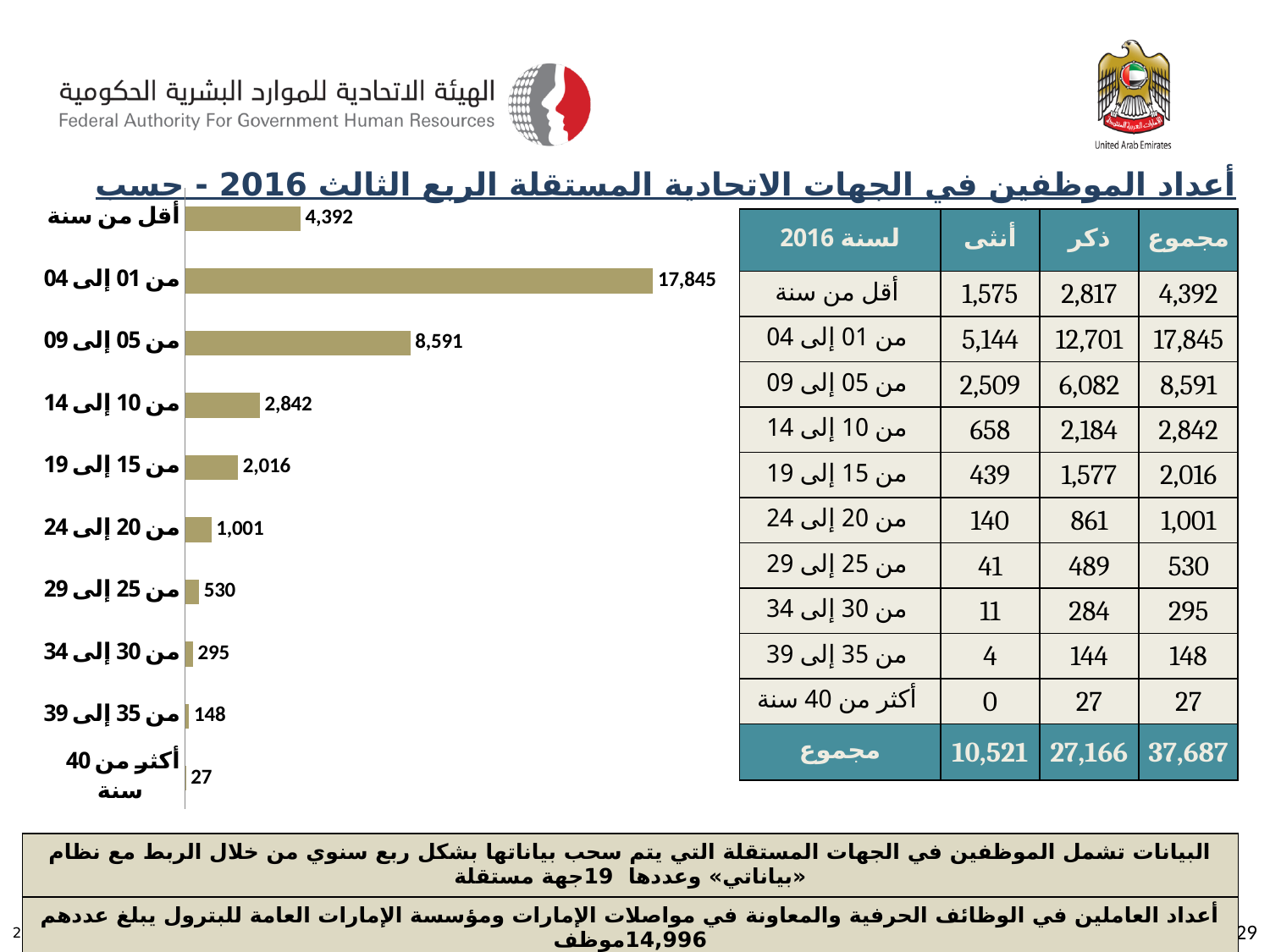
Which category has the highest value in the bar chart? من 01 إلى 04 What is the value for the category "أكثر من 40 سنة" in the bar chart? 27 What is the difference between the values for "من 01 إلى 04" and "من 05 إلى 09" in the bar chart? 9,254 What is the value for the category "من 01 إلى 04" in the bar chart? 17,845 What kind of chart is shown on the slide? Bar chart Which category has the lowest value in the bar chart? أكثر من 40 سنة How many categories are shown in the bar chart? 10 Which is larger in the bar chart: the value for "من 15 إلى 19" or the value for "من 20 إلى 24"? من 15 إلى 19 What is the difference between the values for "أقل من سنة" and "من 10 إلى 14" in the bar chart? 1,550 From the category "من 01 إلى 04" onward, do the bar values rise or fall as you move down the chart? Fall What is the value for the category "من 25 إلى 29" in the bar chart? 530 What is the value for the category "أقل من سنة" in the bar chart? 4,392